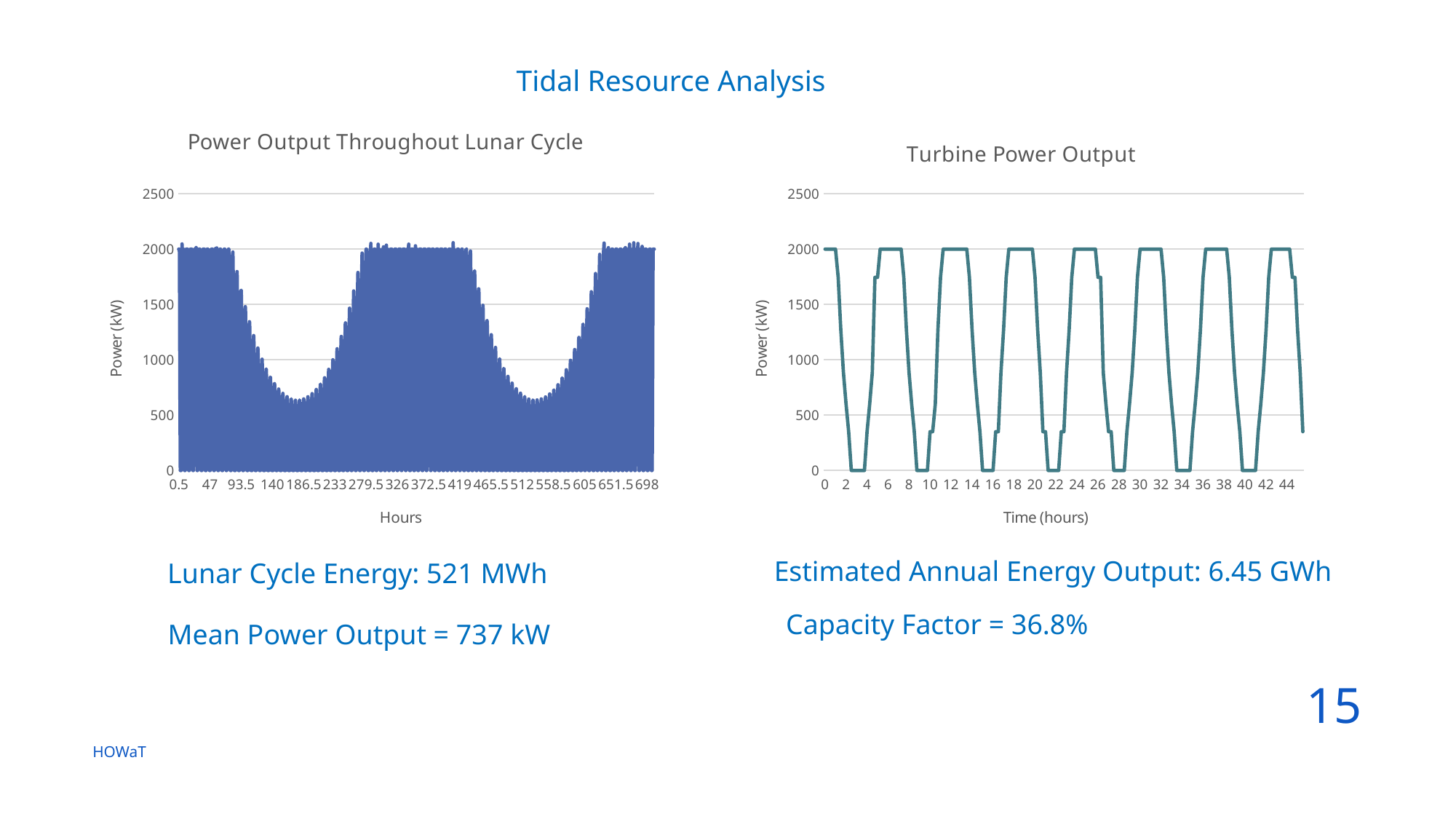
In the 'Power Output Throughout Lunar Cycle' chart, is the lowest point of the envelope near hour 186.5 greater or less than 1000? less In the 'Turbine Power Output' chart, what is the lowest value the line reaches, as read from the y-axis? 0 What is the title of the chart on the left of the slide? Power Output Throughout Lunar Cycle In the 'Turbine Power Output' chart, is the value at hour 6 greater or less than 1500? greater In the 'Turbine Power Output' chart, is the value at hour 3 greater or less than 500? less In the 'Turbine Power Output' chart, what is the maximum power level the plateaus reach, as read from the y-axis? 2000 What is the highest value shown on the y-axis of the 'Power Output Throughout Lunar Cycle' chart? 2500 In the 'Turbine Power Output' chart, what is the y-axis title? Power (kW) In the 'Turbine Power Output' chart, does the line rise or fall between hour 0 and hour 3? fall What kind of chart is the 'Turbine Power Output' chart? line chart In the 'Power Output Throughout Lunar Cycle' chart, which is larger: the envelope value near hour 326 or near hour 512.5? hour 326